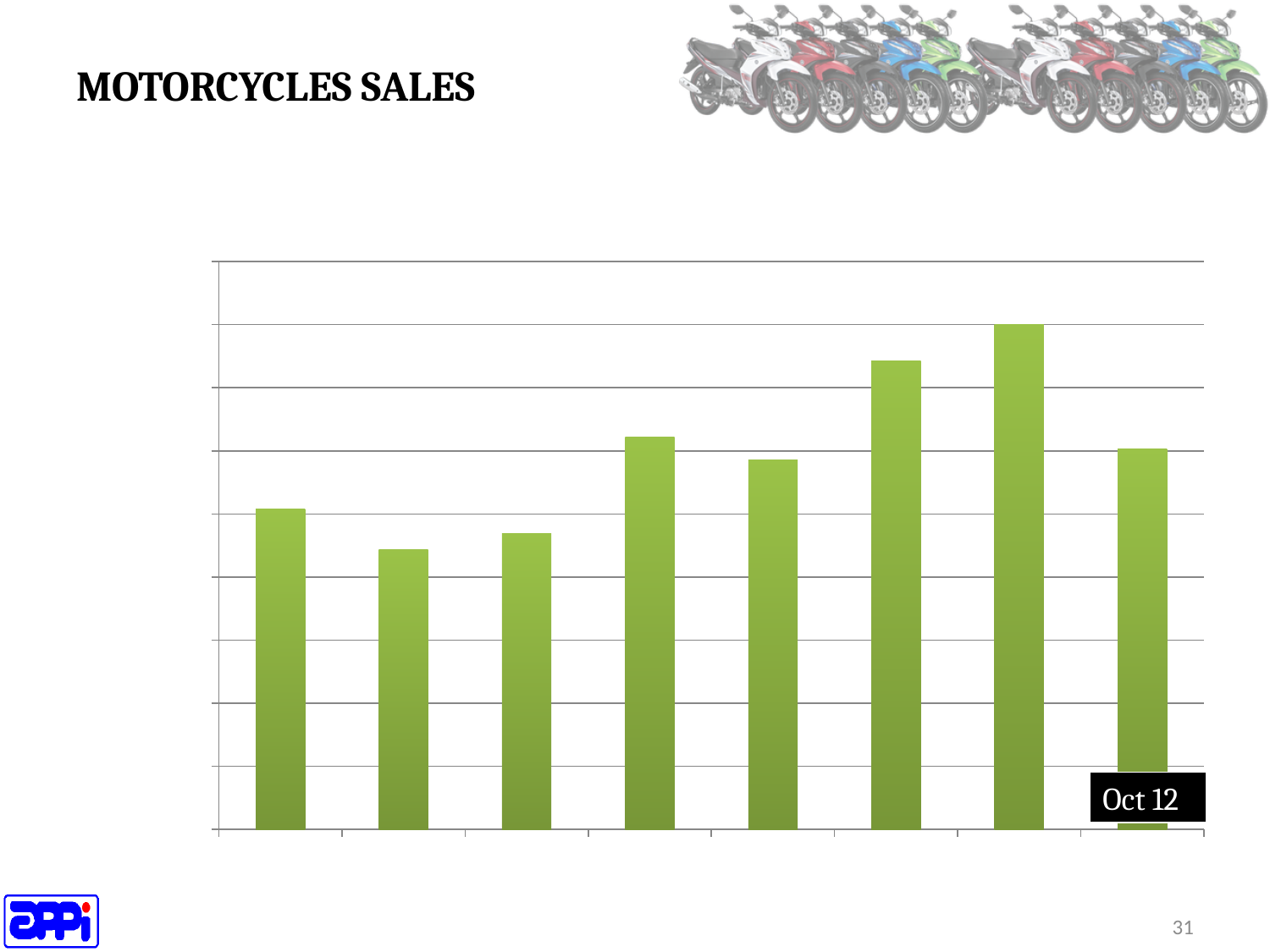
Which is taller, the sixth bar or the seventh bar? the seventh bar What is the title of the slide containing the chart? MOTORCYCLES SALES Which is taller, the fourth bar or the fifth bar? the fourth bar Which is taller, the first bar or the last (eighth) bar? the last (eighth) bar Which bar is the tallest in the chart, counting from the left? the seventh bar How many bars are plotted in the chart? 8 What kind of chart is shown on the slide? bar chart What colour are the bars in the chart? green Which bar is the shortest in the chart, counting from the left? the second bar Do the bars rise or fall from the first bar to the second bar? fall Do the bars rise or fall from the third bar to the fourth bar? rise